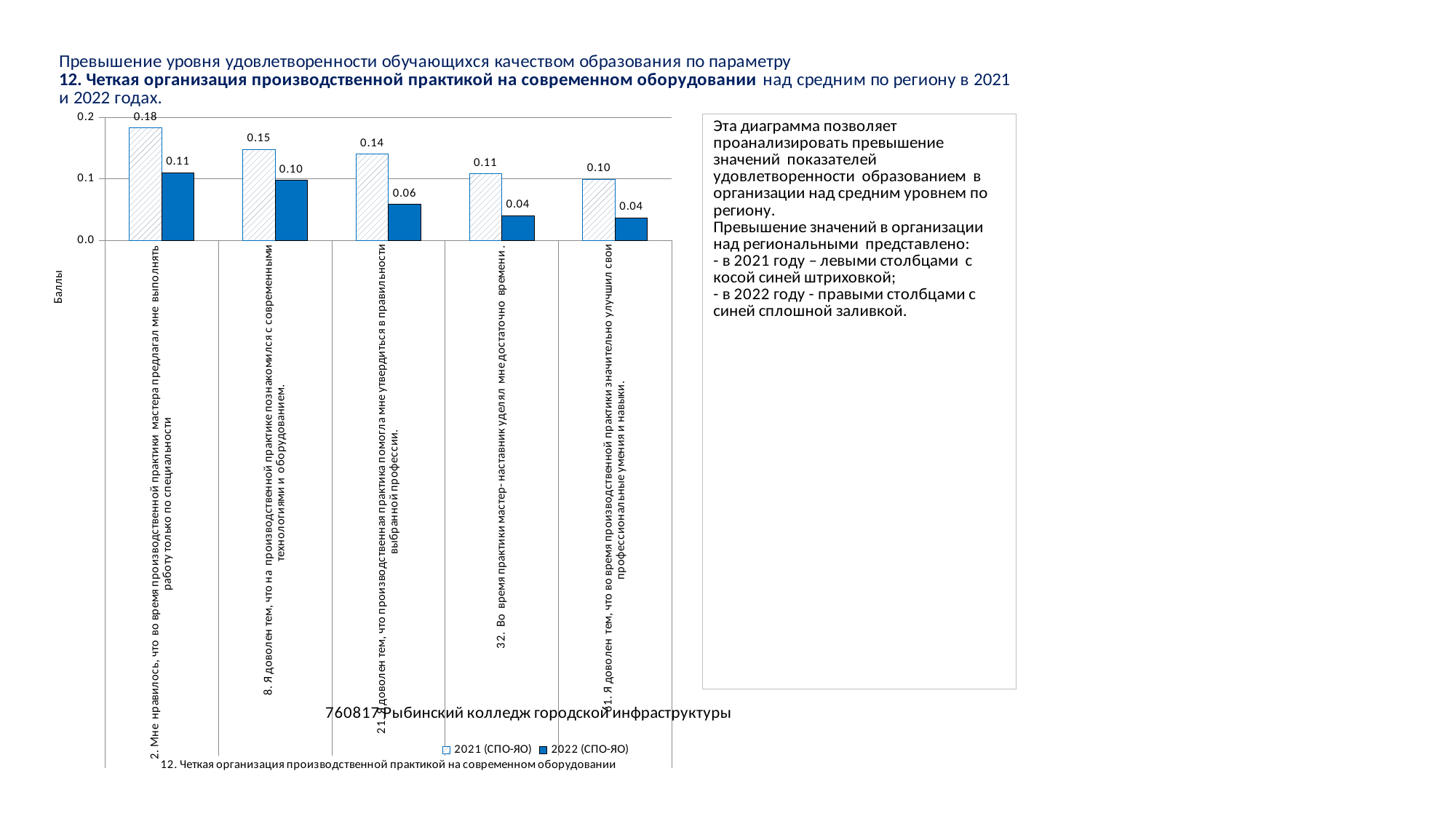
Which category has the highest 2021 (СПО-ЯО) value? 2. Мне нравилось, что во время производственной практики мастер предлагал мне выполнять работу только по специальности How many series does the chart legend list? 2 What is the 2022 (СПО-ЯО) value for category 8 ("Я доволен тем, что на производственной практике познакомился с современными технологиями и оборудованием")? 0.10 What type of chart is shown on the slide? bar chart How many categories are shown on the x axis of the chart? 5 What is the difference between the 2021 and 2022 values for category 32 ("Во время практики мастер-наставник уделял мне достаточно времени")? 0.07 What is the 2022 (СПО-ЯО) value for category 21 ("Я доволен тем, что производственная практика помогла мне утвердиться в правильности выбранной профессии")? 0.06 Which is larger for category 8: the 2021 (СПО-ЯО) value or the 2022 (СПО-ЯО) value? 2021 (СПО-ЯО) Do the 2022 (СПО-ЯО) values rise or fall from the first category to the last along the x axis? fall What is the 2021 (СПО-ЯО) value for category 2 ("Мне нравилось, что во время производственной практики мастер предлагал мне выполнять работу только по специальности")? 0.18 Which category has the lowest 2021 (СПО-ЯО) value? 61. Я доволен тем, что во время производственной практики значительно улучшил свои профессиональные умения и навыки Is the 2021 (СПО-ЯО) value for category 21 greater or less than 0.1? greater